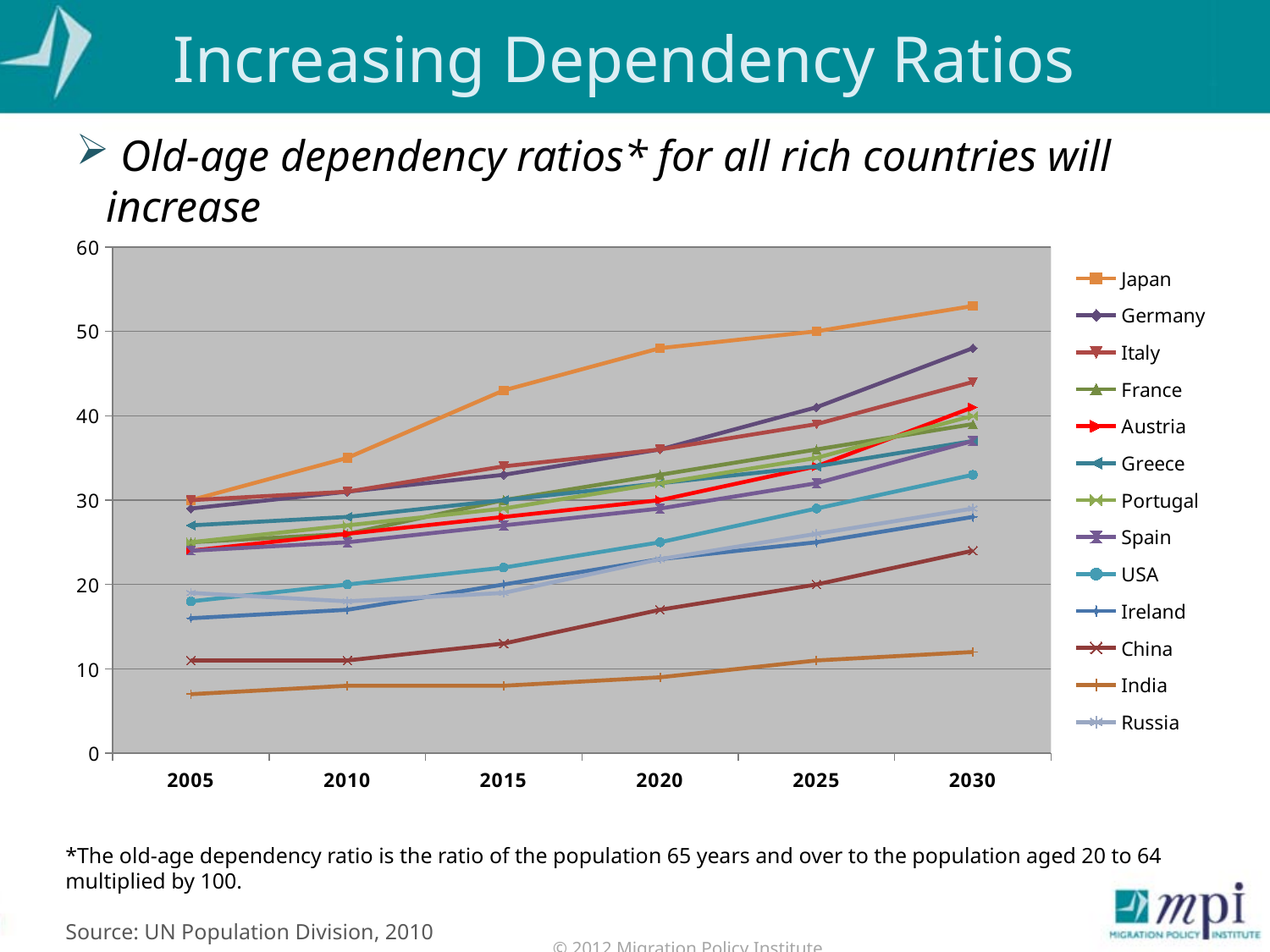
How many countries does the legend list? 13 Does the value for Japan rise or fall from 2005 to 2030? rise Which is larger in 2030, the value for Japan or the value for Germany? Japan Is the value for China in 2030 greater or less than 30? less Is the value for Germany in 2030 greater or less than 40? greater What kind of chart is shown on the slide? line chart Which country has the lowest old-age dependency ratio in 2030? India Which country has the highest old-age dependency ratio in 2030? Japan Is the value for India in 2005 greater or less than 10? less How many years are shown along the x axis? 6 Which is larger in 2030, the value for China or the value for India? China